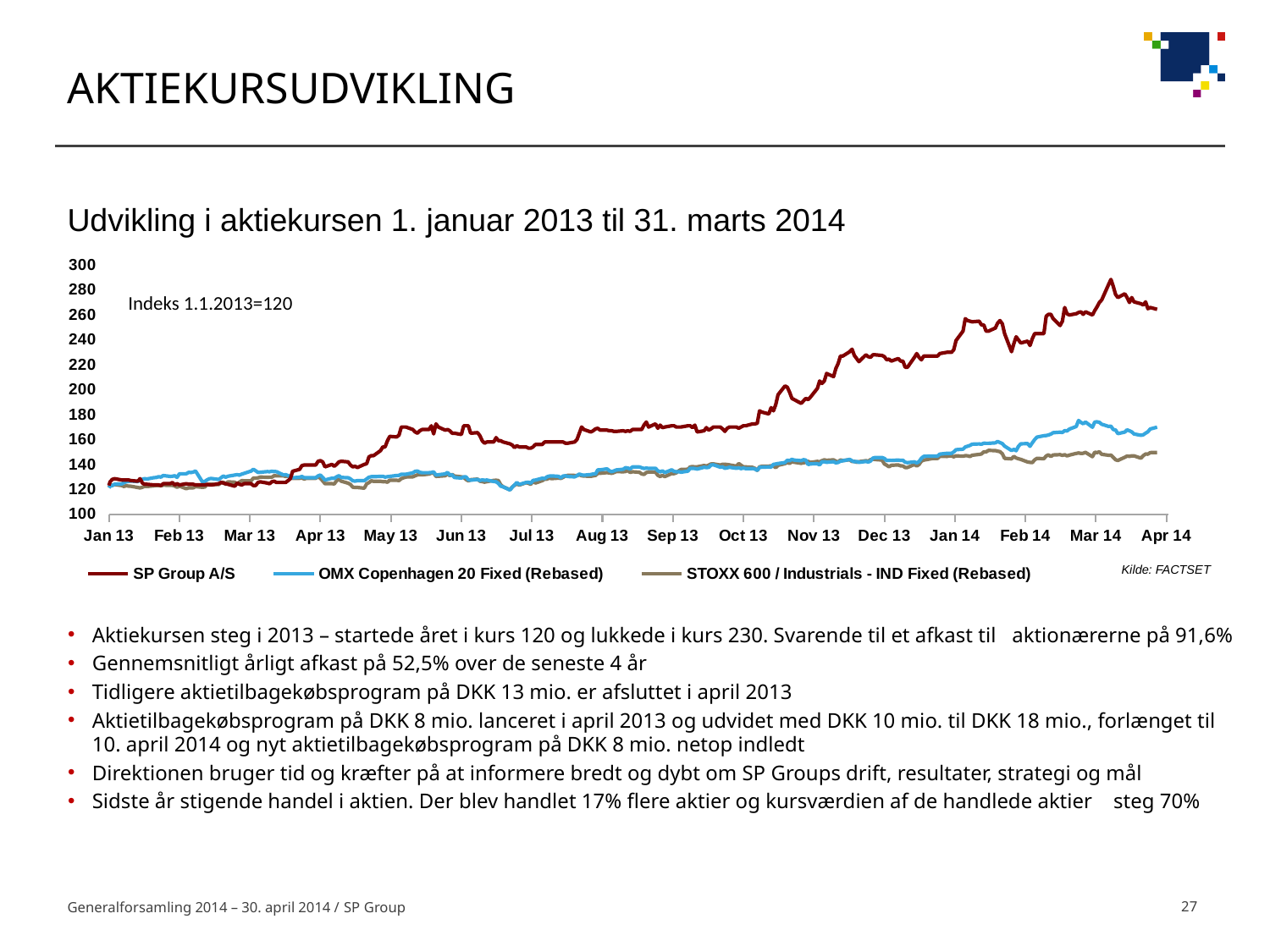
How many series does the chart legend list? 3 At Apr 14, which is larger: OMX Copenhagen 20 Fixed (Rebased) or STOXX 600 / Industrials - IND Fixed (Rebased)? OMX Copenhagen 20 Fixed (Rebased) How many month labels are shown on the x axis? 16 Is the value for SP Group A/S at Nov 13 greater or less than 180? greater What is the title of the chart? Udvikling i aktiekursen 1. januar 2013 til 31. marts 2014 Is the value for STOXX 600 / Industrials - IND Fixed (Rebased) at Apr 14 greater or less than 160? less Does the SP Group A/S line rise or fall overall from Jan 13 to Apr 14? Rise What kind of chart is shown on the slide? Line chart Which series reaches the highest value on the chart? SP Group A/S Is the value for SP Group A/S at Apr 14 greater or less than 240? greater What source is cited for the chart data? FACTSET Which series has the lowest value at Apr 14? STOXX 600 / Industrials - IND Fixed (Rebased)